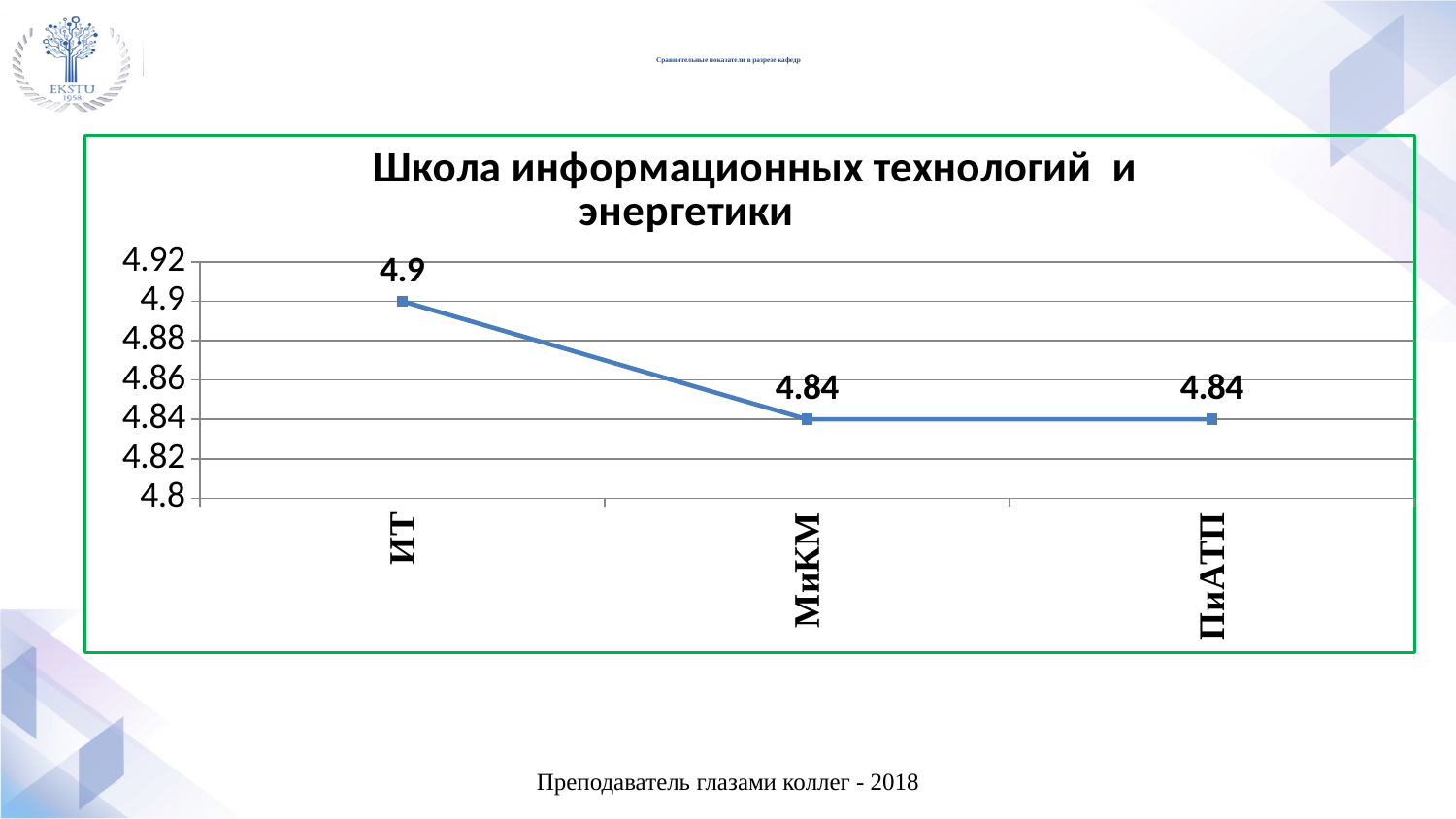
What is the difference between the values for ИТ and МиКМ? 0.06 What is the title of the chart? Школа информационных технологий и энергетики What is the value for ИТ? 4.9 Is the value for МиКМ greater or less than 4.86? less What kind of chart is shown on the slide? line chart How many categories are shown on the x axis? 3 Which category has the highest value? ИТ What is the value for ПиАТП? 4.84 Which is larger, the value for ИТ or the value for ПиАТП? ИТ What is the value for МиКМ? 4.84 Do the values rise or fall from ИТ to МиКМ? fall Is the value for ИТ greater or less than 4.88? greater